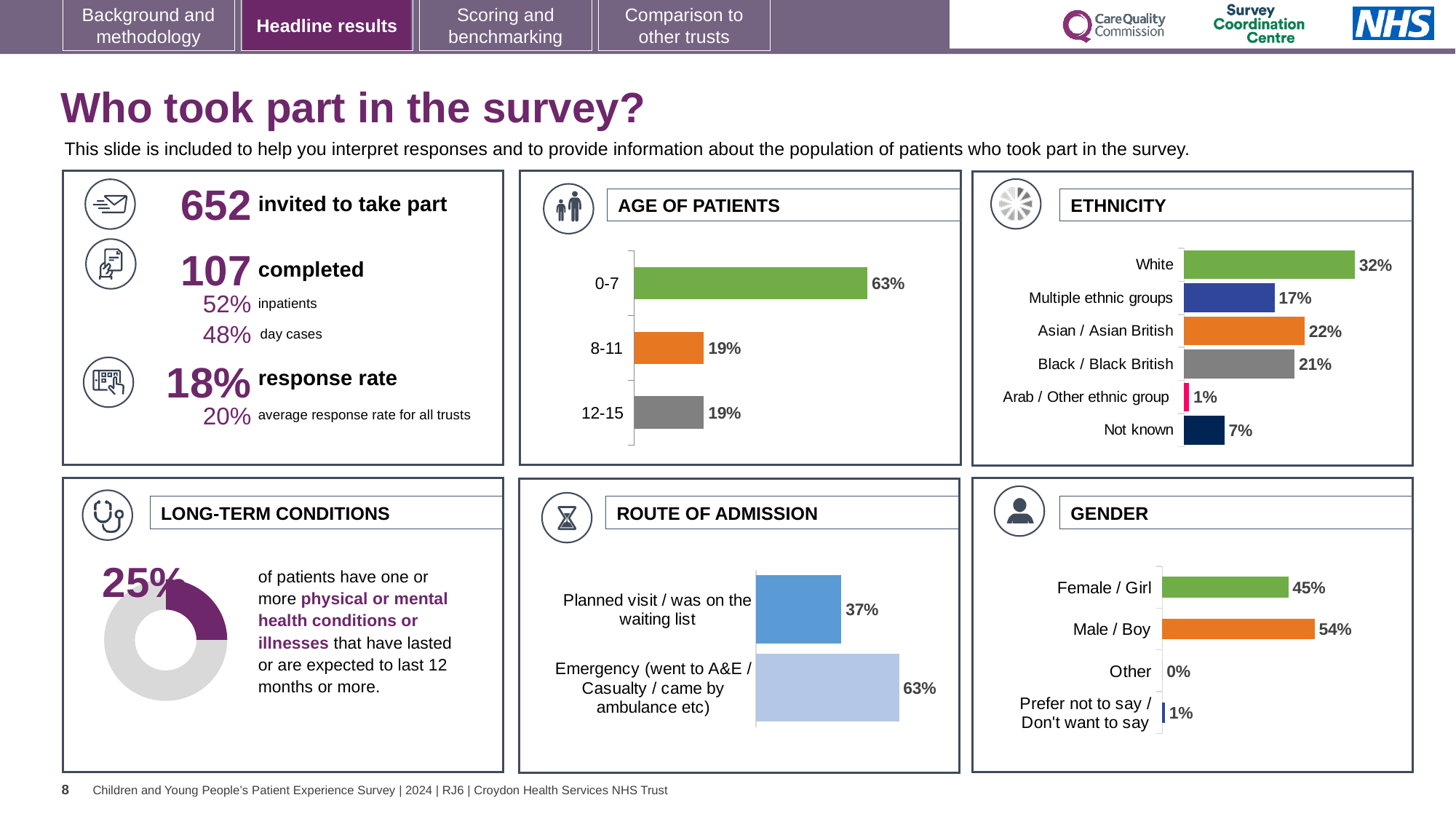
In the ROUTE OF ADMISSION chart, which is larger: Planned visit / was on the waiting list or Emergency? Emergency (went to A&E / Casualty / came by ambulance etc) In the GENDER chart, what is the difference between Male / Boy and Female / Girl? 9% In the AGE OF PATIENTS chart, what percentage of patients were aged 0-7? 63% In the ETHNICITY chart, what is the difference between the White and Multiple ethnic groups values? 15% What kind of chart is used in the LONG-TERM CONDITIONS panel? Doughnut chart In the ROUTE OF ADMISSION chart, what is the value for Emergency (went to A&E / Casualty / came by ambulance etc)? 63% In the ETHNICITY chart, which category has the lowest value? Arab / Other ethnic group In the LONG-TERM CONDITIONS chart, what share of patients have one or more long-term conditions? 25% In the AGE OF PATIENTS chart, which age group has the highest value? 0-7 In the ETHNICITY chart, how many categories are shown? 6 In the ETHNICITY chart, what is the value for Asian / Asian British? 22% In the GENDER chart, what is the value for Male / Boy? 54%